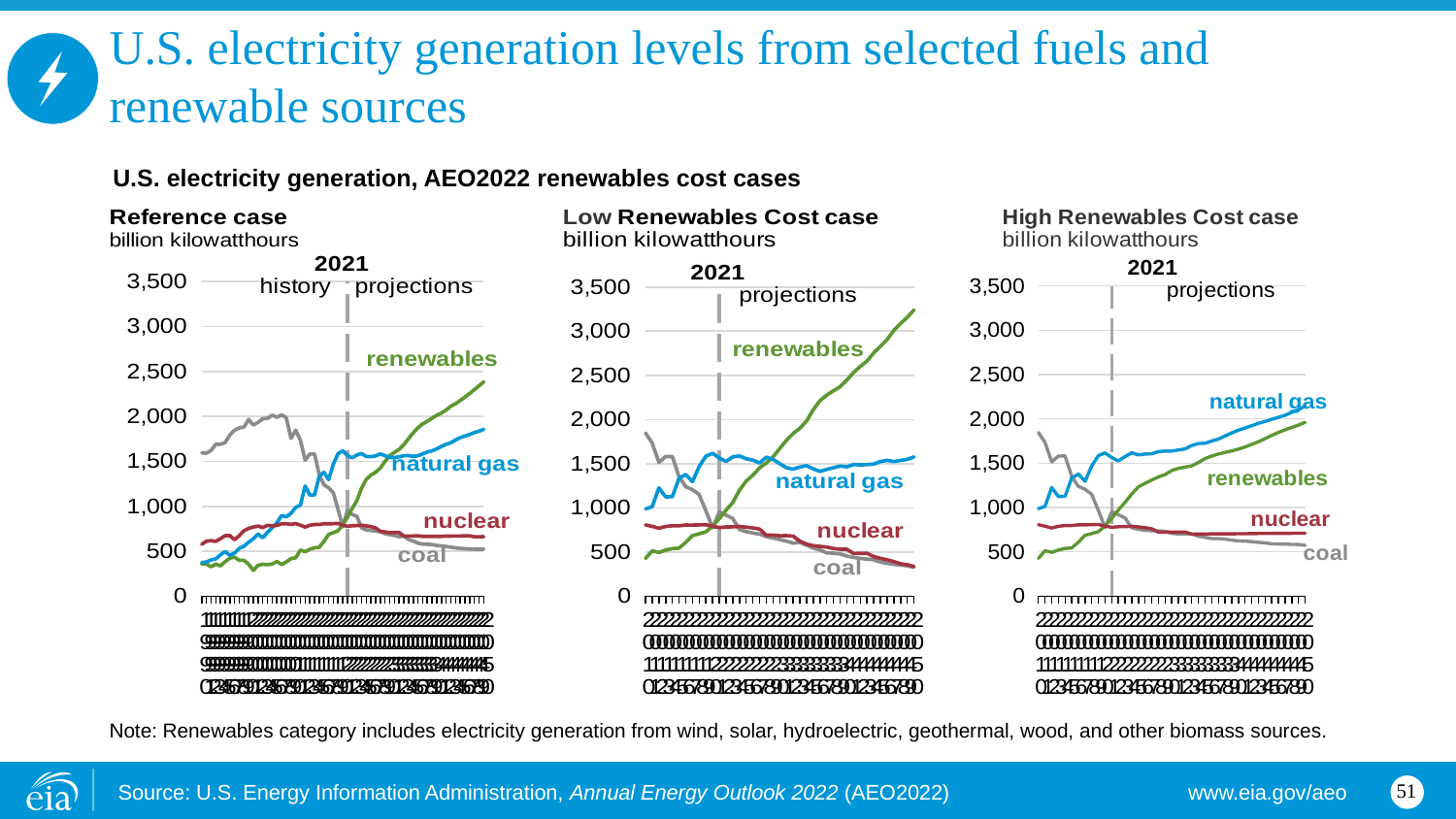
How many charts are shown on the slide? 3 In the Low Renewables Cost case chart, is the value for renewables at the end of the projection period greater or less than 3,000? greater In the Low Renewables Cost case chart, which series is higher at the end of the projection period, renewables or natural gas? renewables What year does the dashed vertical line mark in each chart? 2021 What kind of chart is the Reference case chart? line chart In the Reference case chart, is the value for renewables at the end of the projection period greater or less than 2,000? greater In the High Renewables Cost case chart, is the value for natural gas at the end of the projection period greater or less than 1,500? greater How many fuel series are plotted in the Low Renewables Cost case chart? 4 What unit is used on the y axis of the three charts? billion kilowatthours In the High Renewables Cost case chart, does coal rise or fall over the projection period? fall